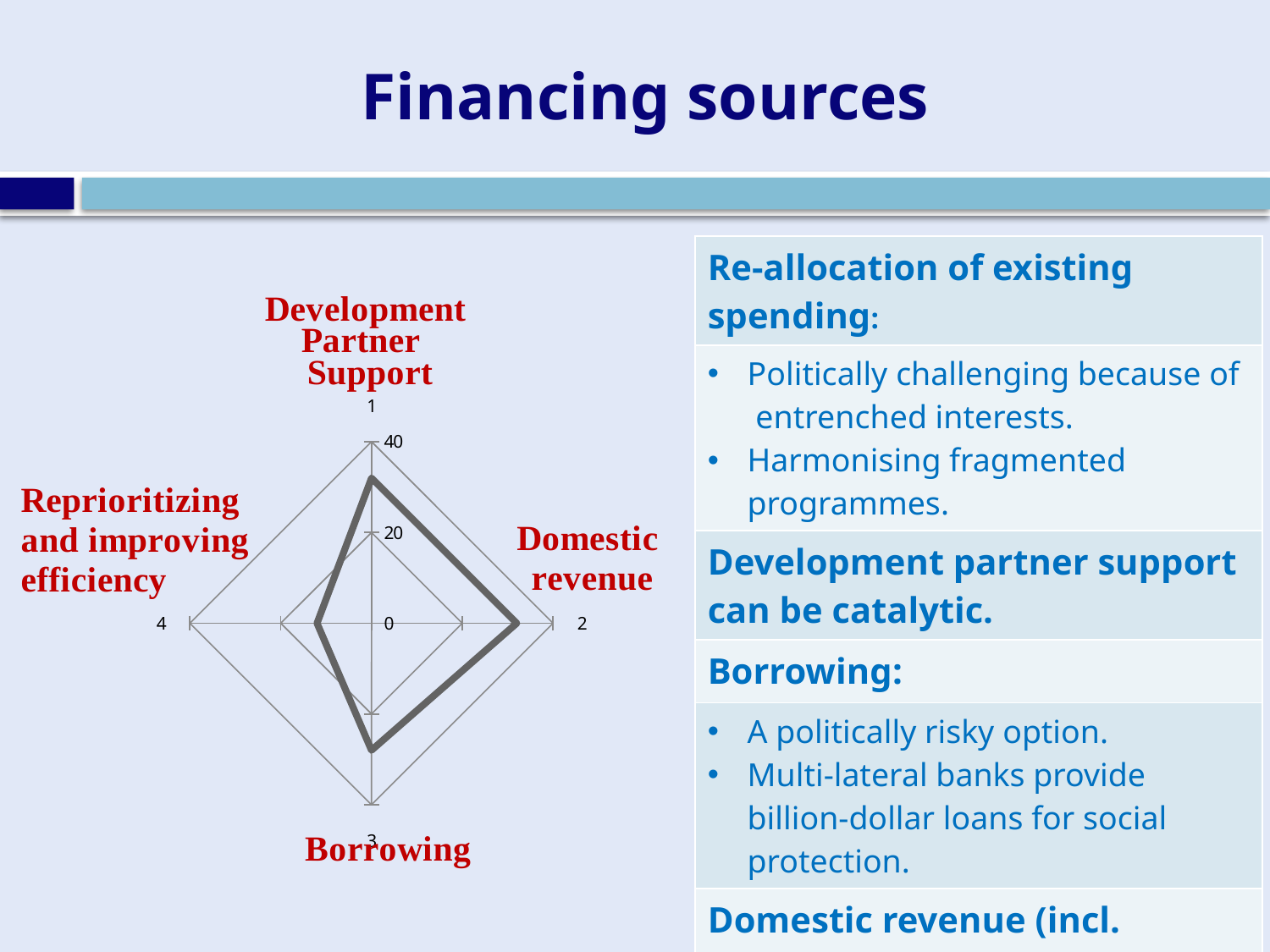
Which is larger, the value for Development Partner Support or the value for Reprioritizing and improving efficiency? Development Partner Support Is the value for Domestic revenue greater or less than 20? greater Which category has the lowest value on the radar chart? Reprioritizing and improving efficiency Which is larger, the value for Borrowing or the value for Reprioritizing and improving efficiency? Borrowing Is the value for Reprioritizing and improving efficiency greater or less than 20? less Is the value for Domestic revenue greater or less than 40? less What kind of chart is shown on the slide? Radar chart What is the highest tick value shown on the radar chart's axis? 40 Which category is positioned at the bottom of the radar chart? Borrowing How many categories (axes) does the radar chart have? 4